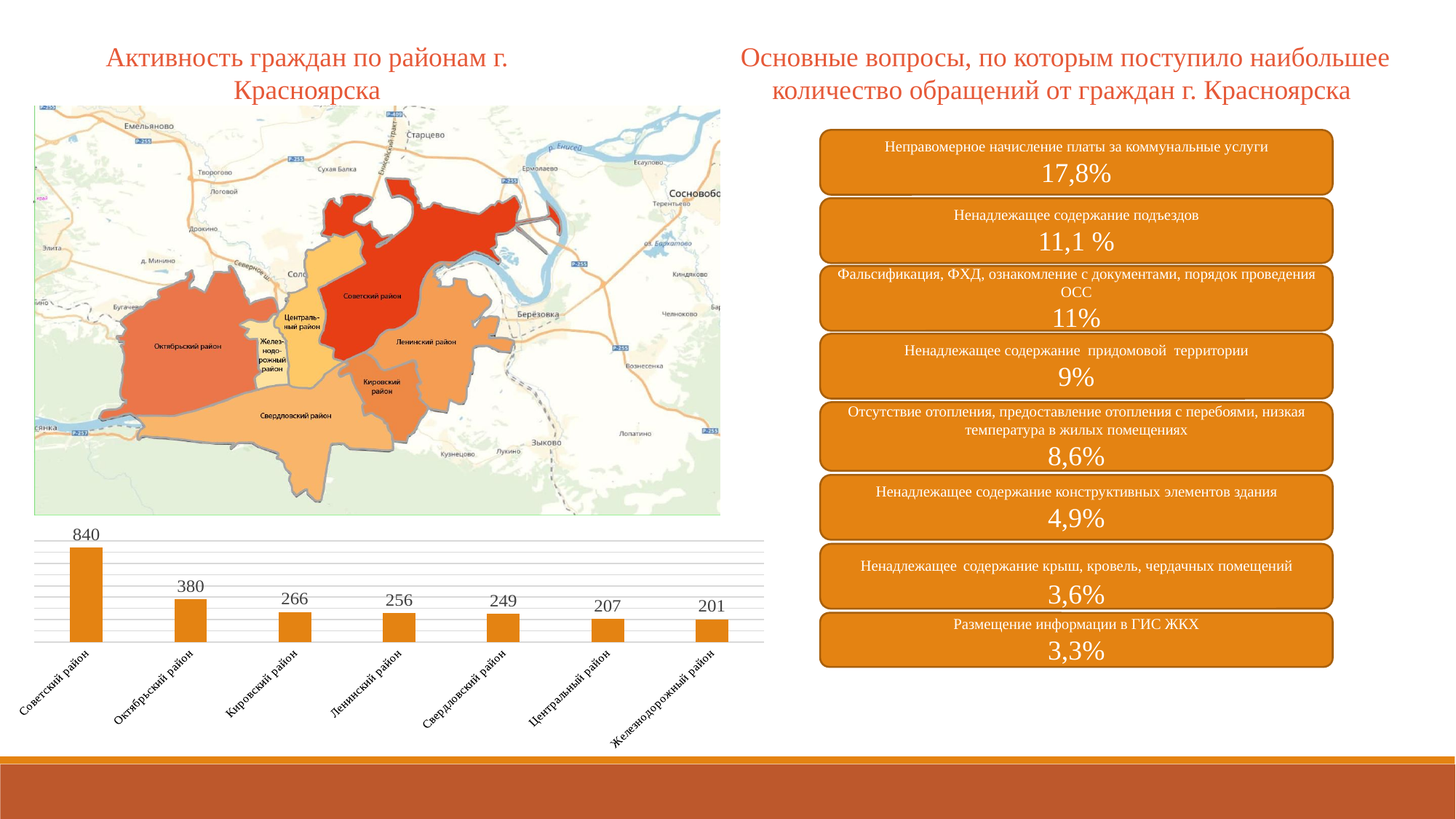
What kind of chart is shown at the bottom left of the slide? Bar chart In the bar chart at the bottom left of the slide, which is larger: the value for Кировский район or the value for Центральный район? Кировский район In the bar chart at the bottom left of the slide, which district has the highest value? Советский район In the bar chart at the bottom left of the slide, what is the value for Октябрьский район? 380 In the bar chart at the bottom left of the slide, what is the difference between the values for Советский район and Октябрьский район? 460 How many districts are shown in the bar chart at the bottom left of the slide? 7 In the bar chart at the bottom left of the slide, do the values rise or fall from left to right? Fall In the bar chart at the bottom left of the slide, what is the value for Советский район? 840 In the bar chart at the bottom left of the slide, which district has the lowest value? Железнодорожный район In the bar chart at the bottom left of the slide, what is the value for Кировский район? 266 In the bar chart at the bottom left of the slide, what is the value for Железнодорожный район? 201 In the bar chart at the bottom left of the slide, what is the difference between the values for Ленинский район and Свердловский район? 7